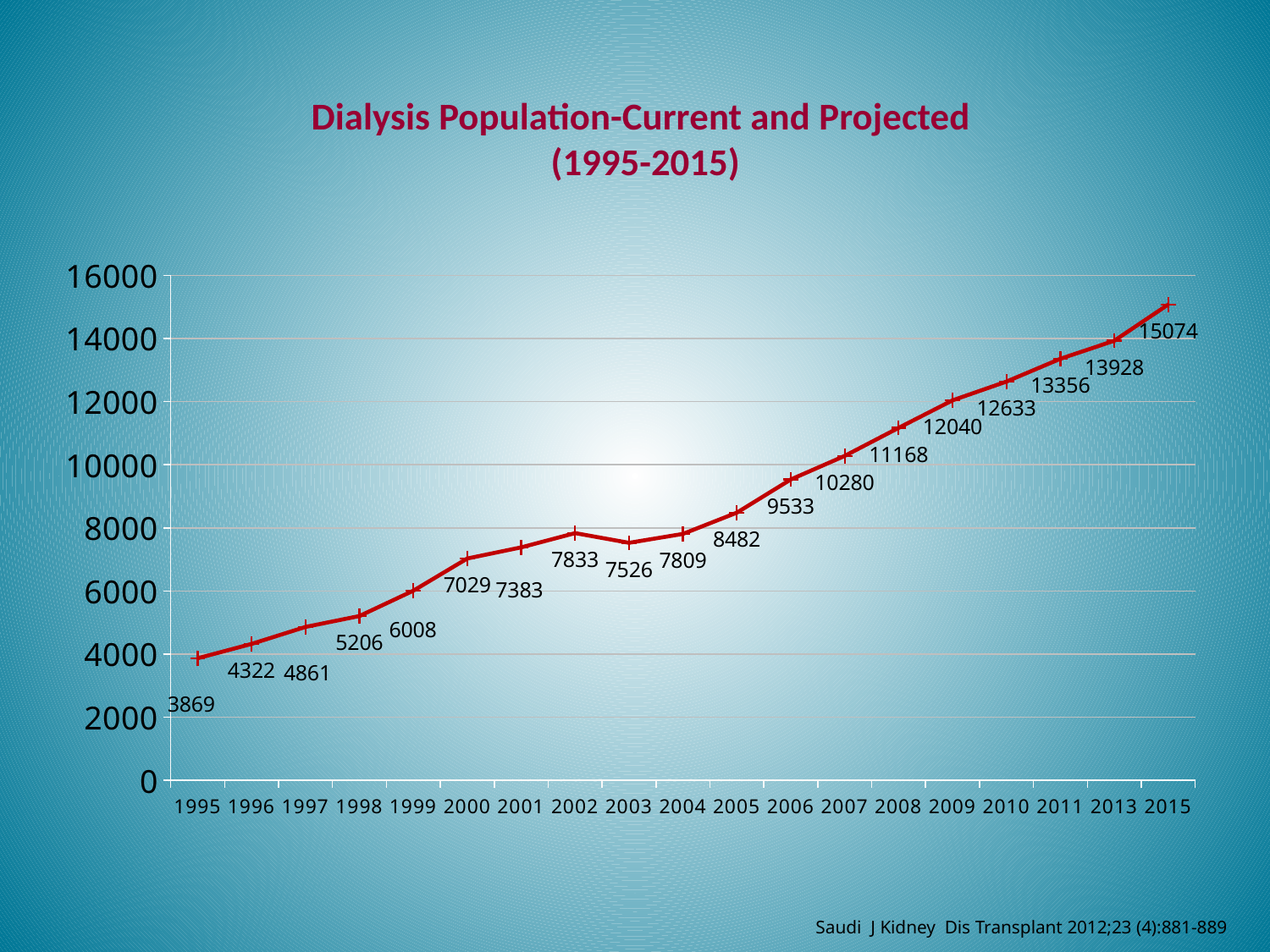
What is the title of the chart? Dialysis Population-Current and Projected (1995-2015) What type of chart is shown on the slide? Line chart What is the projected dialysis population value for 2015? 15074 Which year has the highest dialysis population value? 2015 What is the dialysis population value for 1995? 3869 Which year has the lowest dialysis population value? 1995 How many data points are plotted on the chart? 19 Does the dialysis population generally rise or fall from 1995 to 2015? Rise What is the dialysis population value for 2008? 11168 Which is larger, the value for 2002 or the value for 2003? 2002 What is the difference between the values for 2015 and 1995? 11205 What is the dialysis population value for 2003? 7526